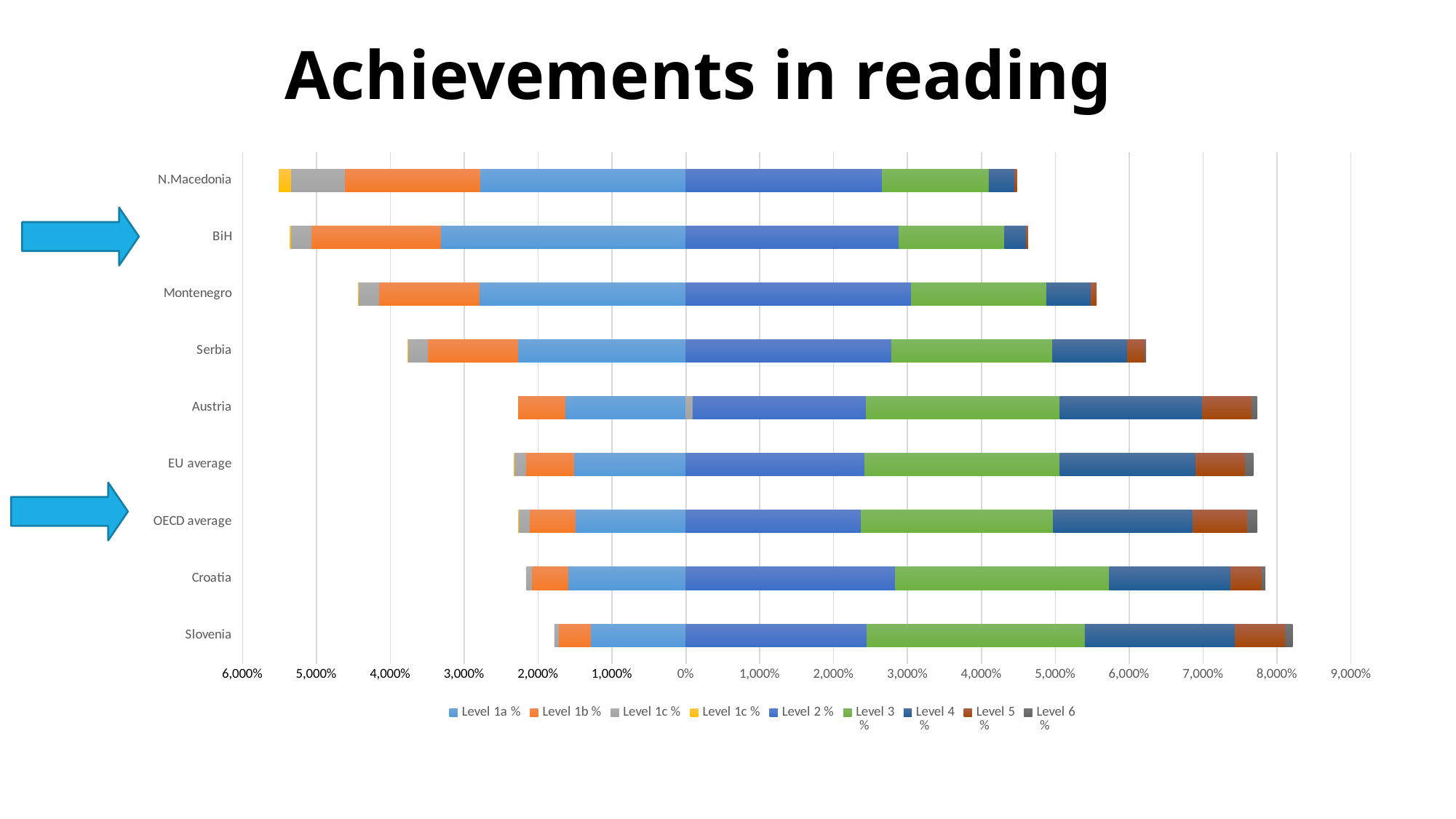
Which bar extends further to the right of 0%, Slovenia or N.Macedonia? Slovenia Does the right end of the Serbia bar extend to a value greater or less than 6,000%? greater Does the right end of the Slovenia bar extend to a value greater or less than 8,000%? greater What type of chart is shown on the slide? Stacked bar chart Does the left end of the N.Macedonia bar extend to a value greater or less than 5,000% on the left side of the axis? greater Which bar extends further to the left of 0%, N.Macedonia or Austria? N.Macedonia Which category is listed at the top of the chart? N.Macedonia How many countries or averages are listed on the vertical axis of the chart? 9 What is the title of the chart? Achievements in reading How many series does the chart legend list? 9